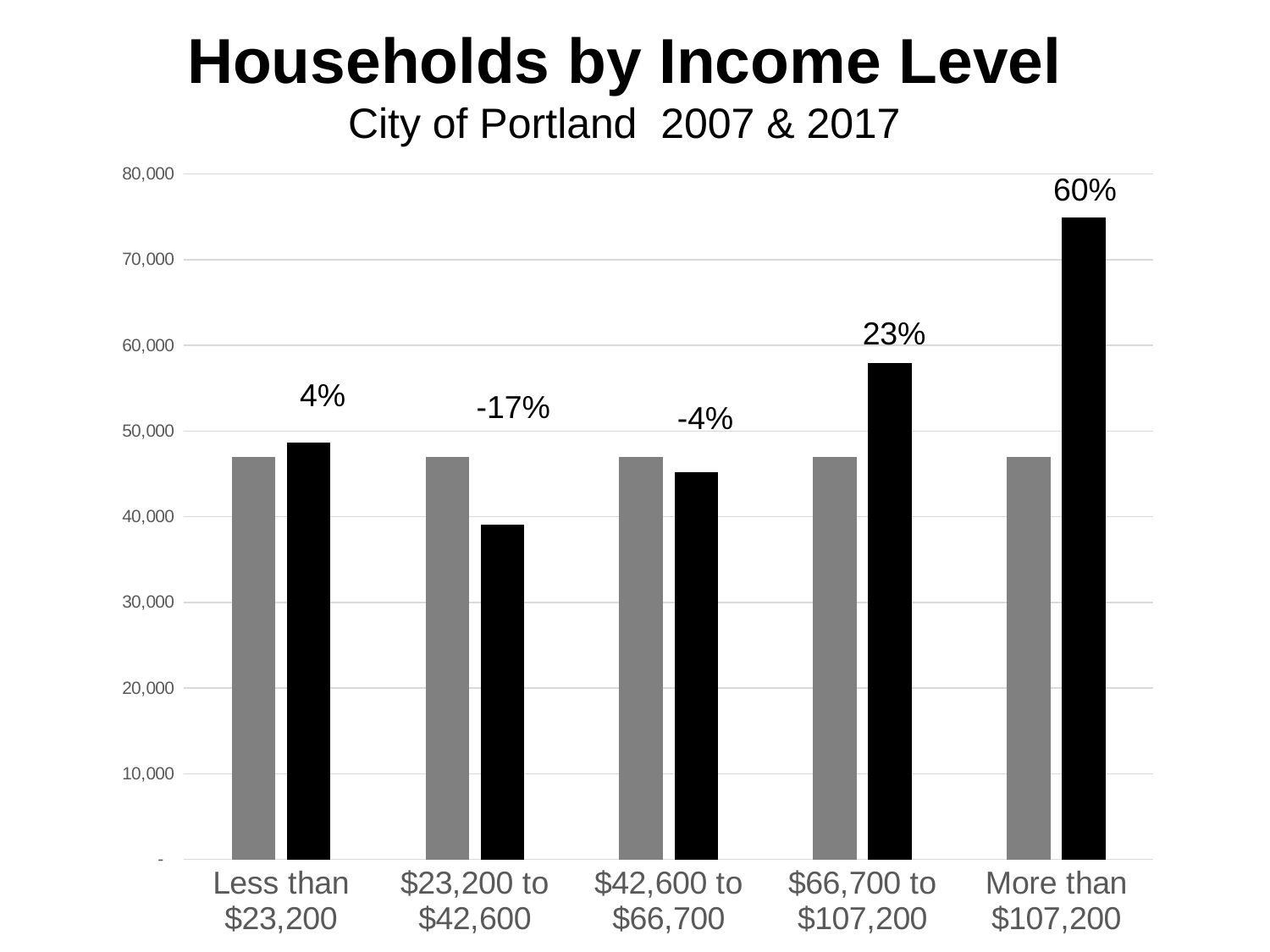
What percentage change label is shown for the "$23,200 to $42,600" category? -17% What percentage change label is shown above the black bar for the "More than $107,200" category? 60% Which income category has the shortest black bar? $23,200 to $42,600 How many income categories are shown on the x axis? 5 Is the black bar for "$23,200 to $42,600" greater or less than 40,000? less What percentage change label is shown for the "Less than $23,200" category? 4% Is the black bar for "More than $107,200" greater or less than 70,000? greater What type of chart is shown on the slide? Bar chart Which income category has the tallest black bar? More than $107,200 Which is larger: the black bar for "$66,700 to $107,200" or the black bar for "$42,600 to $66,700"? $66,700 to $107,200 What percentage change label is shown for the "$66,700 to $107,200" category? 23% What is the title of the chart? Households by Income Level